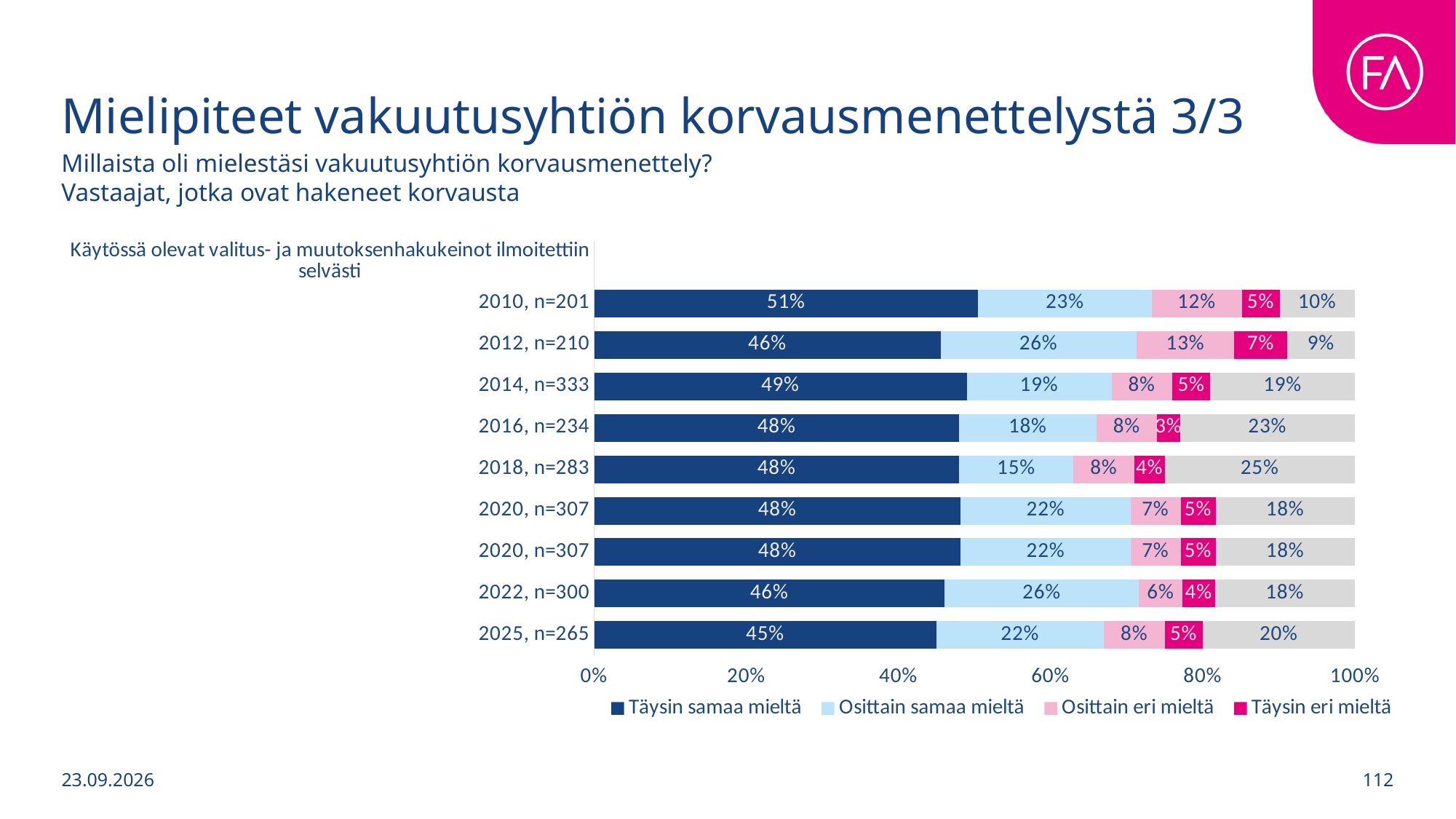
Which year has the lowest "Täysin samaa mieltä" share? 2025, n=265 What percentage of respondents in 2010, n=201 answered "Täysin samaa mieltä"? 51% What is the "Osittain samaa mieltä" value for 2022, n=300? 26% What is the "Täysin eri mieltä" value for 2012, n=210? 7% What is the difference between the "Täysin samaa mieltä" values for 2010, n=201 and 2025, n=265? 6 percentage points Which is larger: the "Osittain samaa mieltä" value for 2012, n=210 or for 2018, n=283? 2012, n=210 How many bars (year categories) are shown in the chart? 9 What kind of chart is shown on the slide? Stacked bar chart What is the "Osittain eri mieltä" value for 2025, n=265? 8% What is the combined share of "Täysin samaa mieltä" and "Osittain samaa mieltä" for 2014, n=333? 68% Which year has the highest "Täysin samaa mieltä" share? 2010, n=201 How many series does the legend list? 4